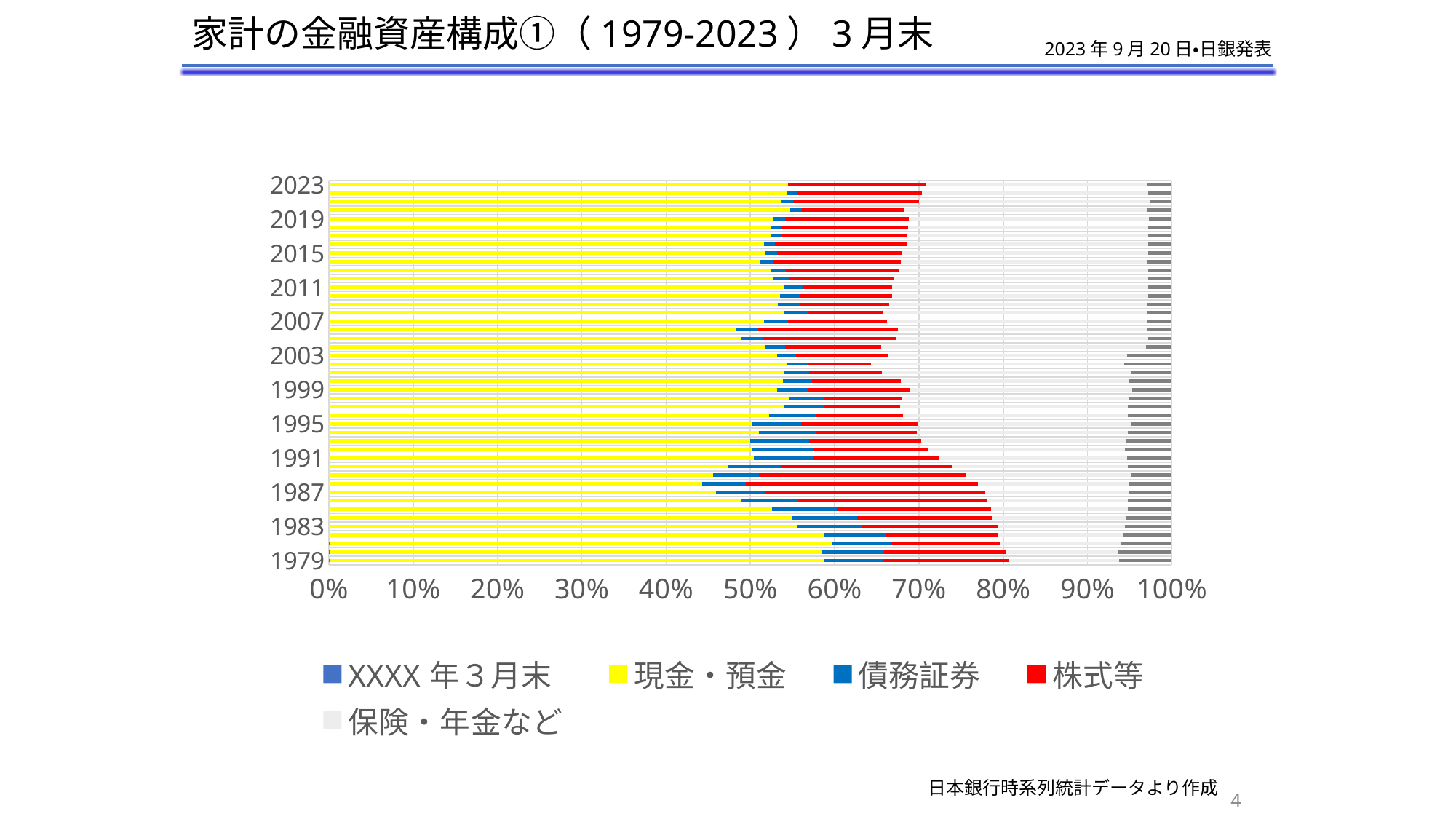
What is the highest value shown on the horizontal axis? 100% Is the 現金・預金 share for 1987 greater or less than 50%? less Which year has the larger 現金・預金 share, 1987 or 2023? 2023 Is the 現金・預金 share for 2023 greater or less than 50%? greater Which year has the larger 株式等 share, 1987 or 2023? 1987 Which colour represents 株式等 in the chart? Red How many series does the legend list? 5 Is the 株式等 share for 1987 greater or less than 20%? greater Which year has the larger 債務証券 share, 1979 or 2023? 1979 What is the title of the chart on the slide? 家計の金融資産構成①（1979-2023）3月末 What kind of chart is shown on the slide? Stacked bar chart Does the 債務証券 share rise or fall from 1979 to 2023? fall